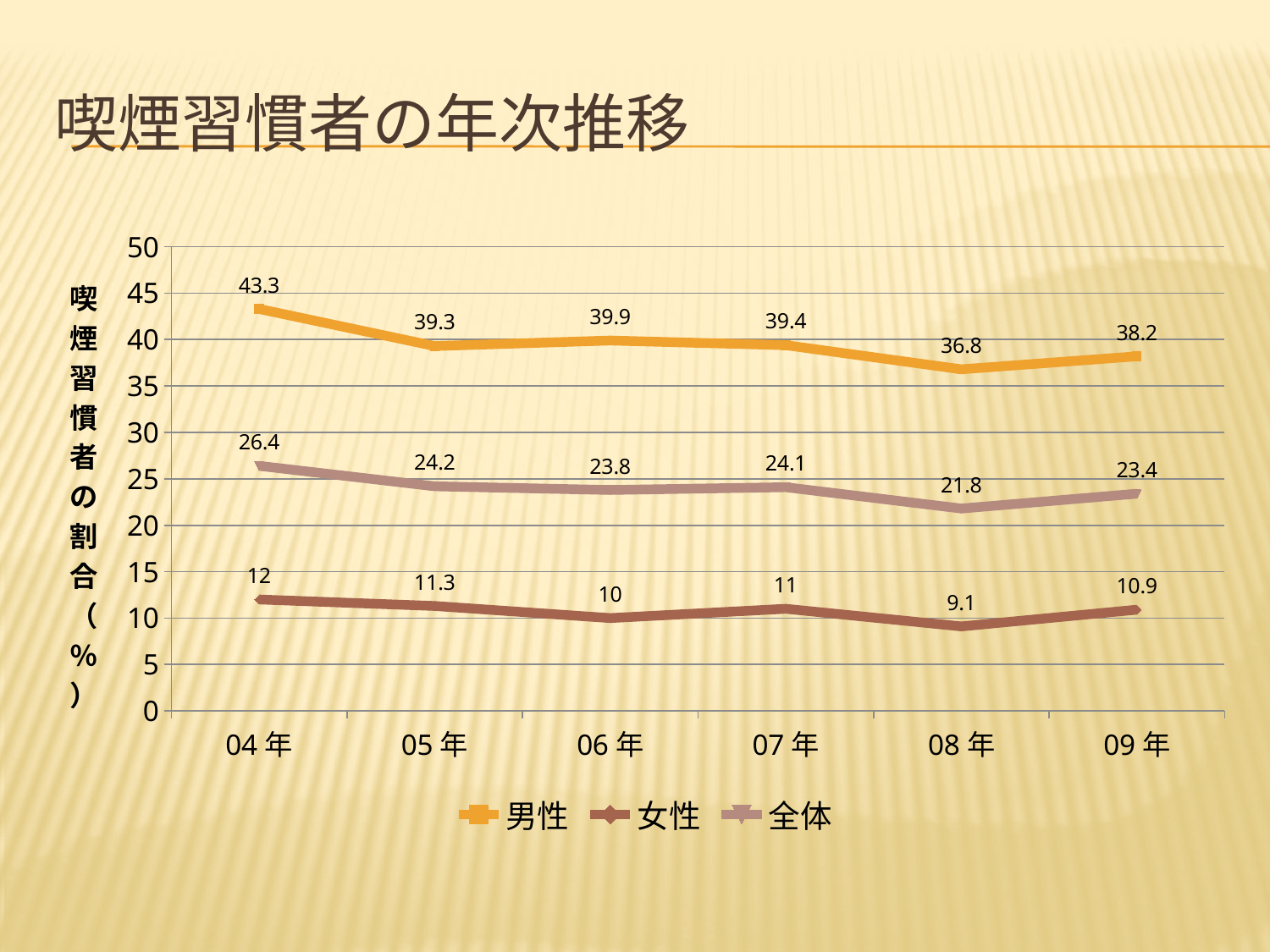
What is the value for 全体 in 09年? 23.4 In which year is the 全体 value highest? 04年 What is the difference between the 男性 value in 04年 and in 09年? 5.1 In which year is the 男性 value lowest? 08年 What is the title of the slide? 喫煙習慣者の年次推移 What kind of chart is this? line chart How many years are shown on the x axis? 6 What is the value for 男性 in 04年? 43.3 Which is larger, the 女性 value in 05年 or in 07年? 05年 What is the value for 女性 in 08年? 9.1 How many series does the legend list? 3 Does the 男性 series generally rise or fall from 04年 to 09年? fall